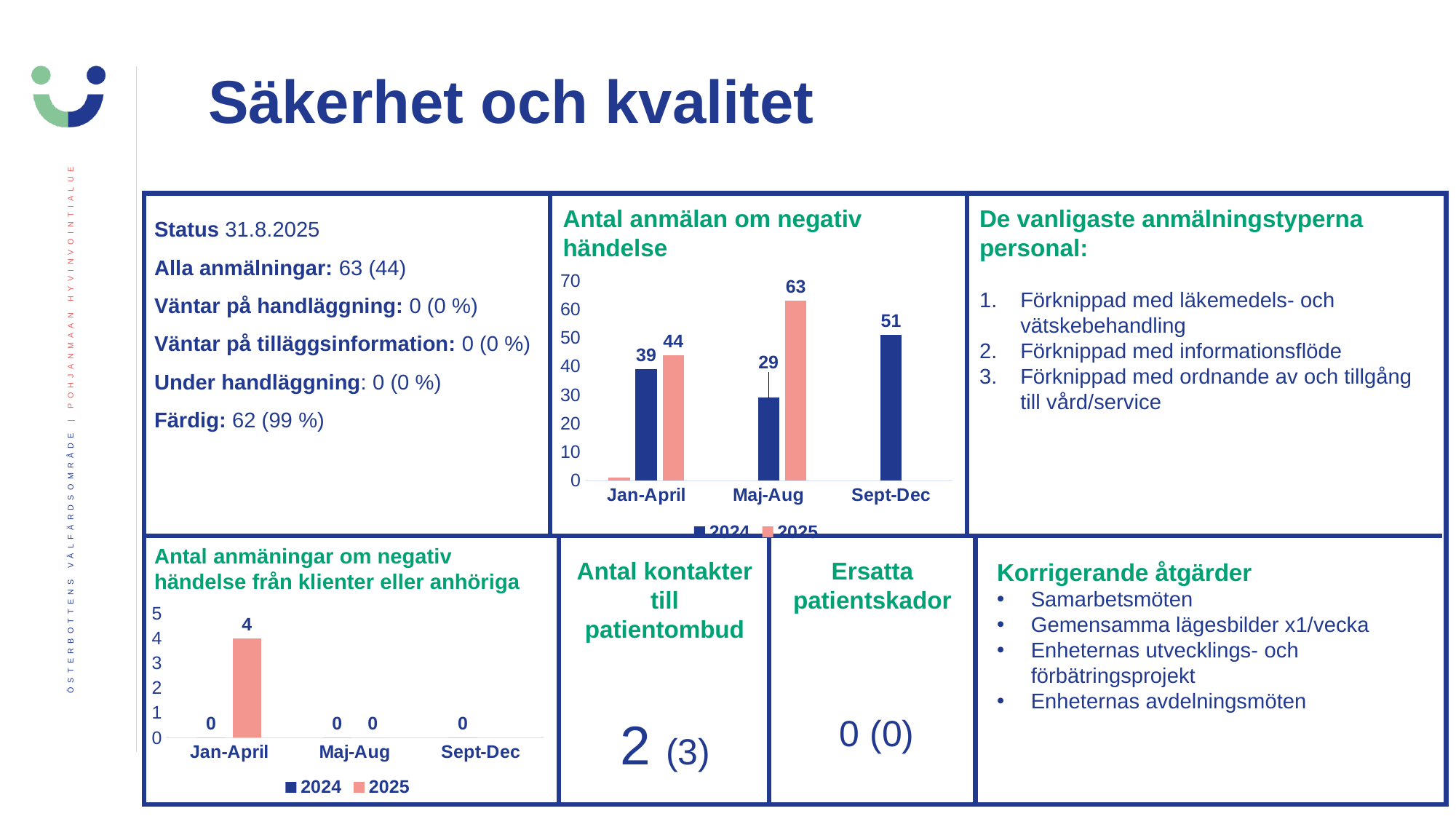
In the chart 'Antal anmälan om negativ händelse', which period has the highest 2025 value? Maj-Aug In the chart 'Antal anmälan om negativ händelse', which period has the lowest 2024 value? Maj-Aug In the chart 'Antal anmälan om negativ händelse', what is the difference between the 2025 and 2024 values in Maj-Aug? 34 What kind of chart is 'Antal anmälan om negativ händelse'? Bar chart In the chart 'Antal anmälan om negativ händelse', which is larger in Jan-April: the 2024 value or the 2025 value? 2025 In the chart 'Antal anmäningar om negativ händelse från klienter eller anhöriga', how many periods are shown on the x axis? 3 In the chart 'Antal anmäningar om negativ händelse från klienter eller anhöriga', what is the value for 2025 in Jan-April? 4 In the chart 'Antal anmälan om negativ händelse', what is the value for 2025 in Maj-Aug? 63 In the chart 'Antal anmälan om negativ händelse', what is the value for 2024 in Sept-Dec? 51 In the chart 'Antal anmälan om negativ händelse', how many series does the legend list? 2 In the chart 'Antal anmäningar om negativ händelse från klienter eller anhöriga', what is the value for 2024 in Maj-Aug? 0 In the chart 'Antal anmälan om negativ händelse', what is the value for 2024 in Jan-April? 39